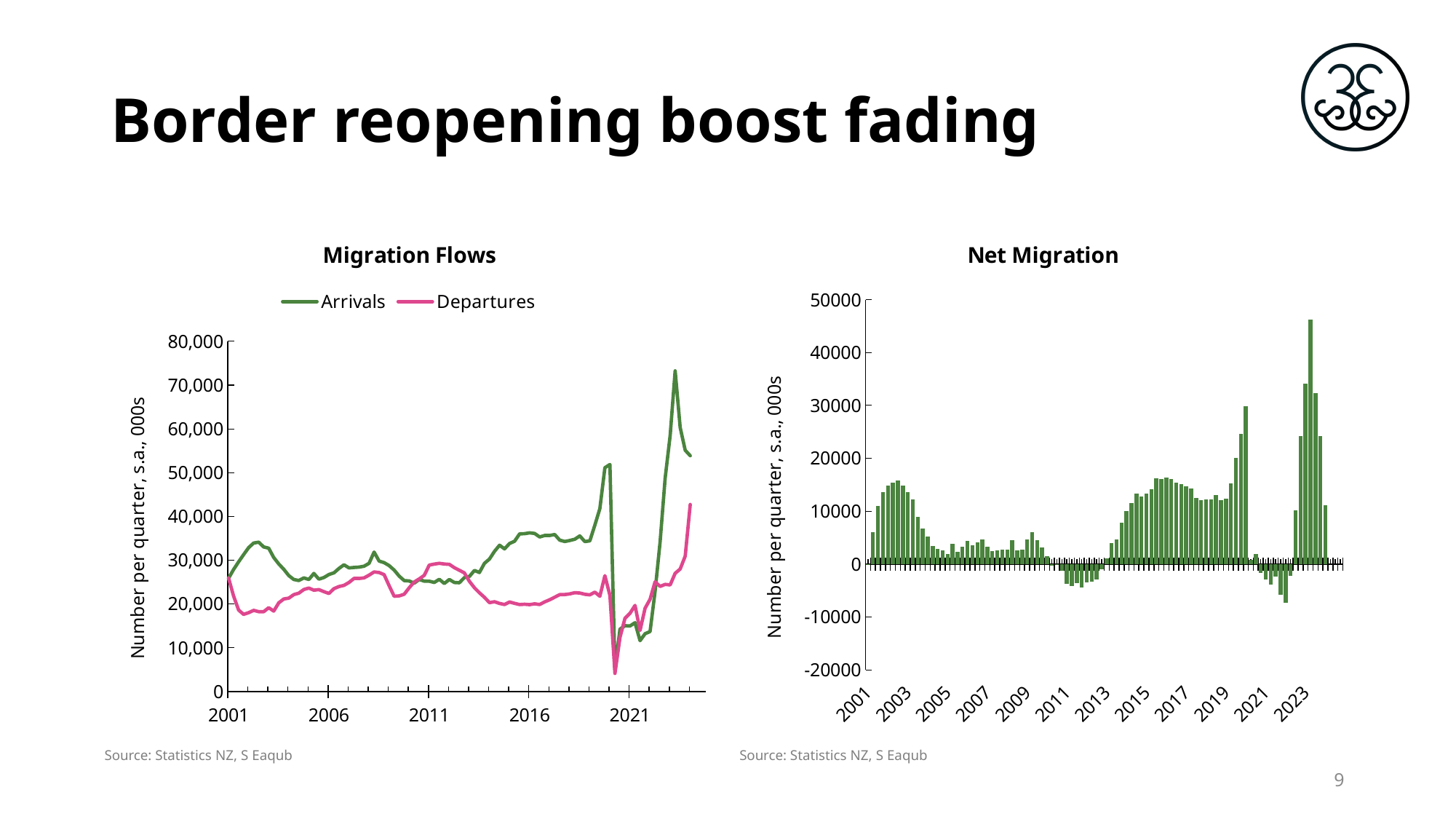
What type of chart is the Migration Flows chart? line chart In the Net Migration chart, is the highest bar (around 2023) greater or less than 40000? greater In the Net Migration chart, is the lowest bar (around 2021-2022) greater or less than -5000? less What is the y-axis label on the Net Migration chart? Number per quarter, s.a., 000s In the Migration Flows chart, is the peak value of Arrivals around 2023 greater or less than 60,000? greater What are the two series named in the legend of the Migration Flows chart? Arrivals and Departures In the Migration Flows chart, do Arrivals rise or fall between 2021 and 2023? rise What type of chart is the Net Migration chart? bar chart In the Migration Flows chart, which series is larger in 2016, Arrivals or Departures? Arrivals In the Net Migration chart, do the bars rise or fall from 2012 to 2016? rise How many series does the legend of the Migration Flows chart list? 2